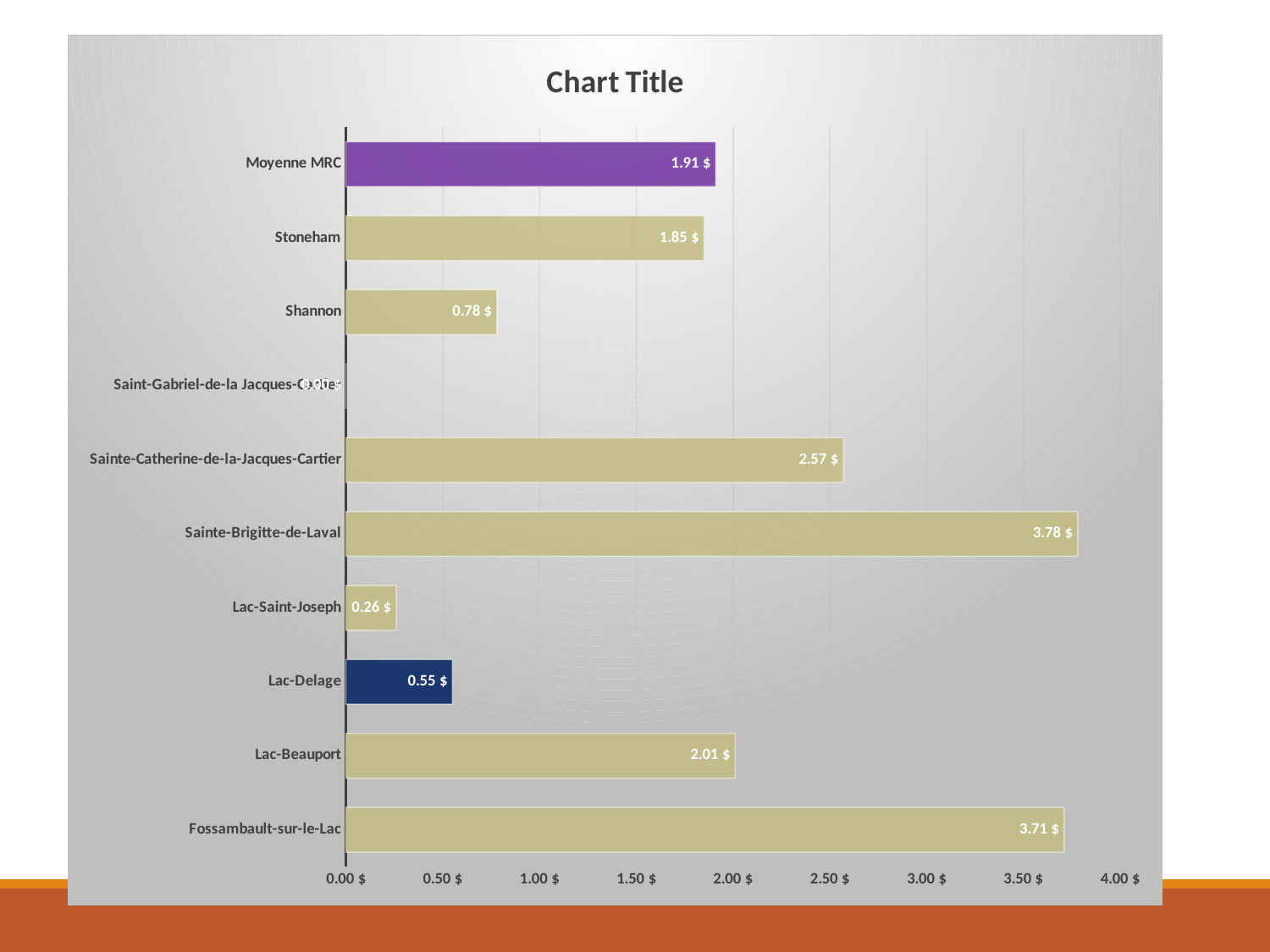
What is the title of the chart? Chart Title What is the difference between the values for Sainte-Brigitte-de-Laval and Fossambault-sur-le-Lac? 0.07 $ Which category has the highest value? Sainte-Brigitte-de-Laval Which is larger, the value for Stoneham or the value for Lac-Beauport? Lac-Beauport Which category has the lowest value? Saint-Gabriel-de-la Jacques-Cartier What is the value for Lac-Delage? 0.55 $ Is the value for Shannon greater or less than 1.00 $? less What kind of chart is shown on the slide? bar chart How many categories are shown on the chart? 10 What is the value for Lac-Saint-Joseph? 0.26 $ What is the value for Sainte-Brigitte-de-Laval? 3.78 $ What is the value for Moyenne MRC? 1.91 $